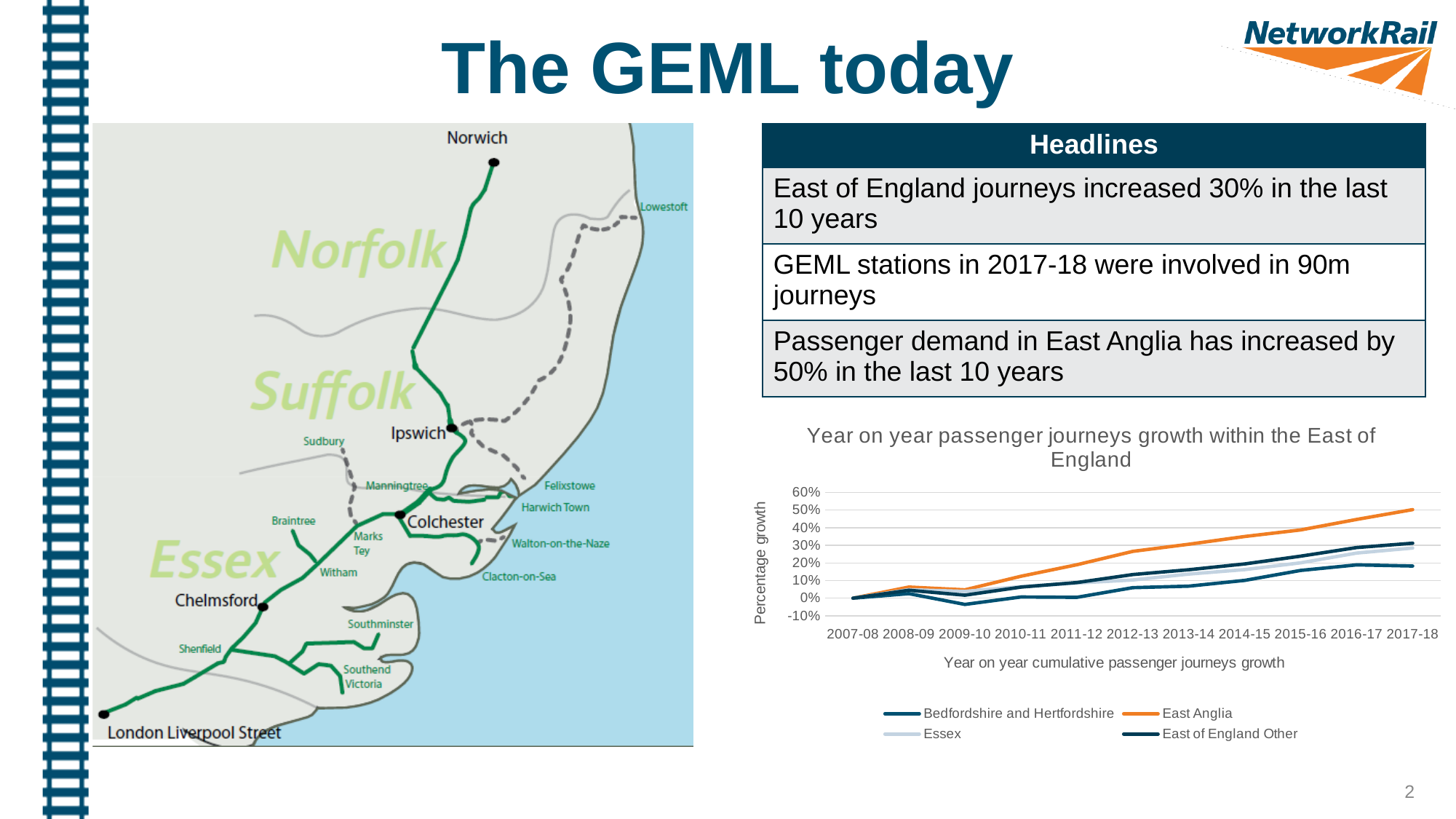
Is the value for Bedfordshire and Hertfordshire in 2017-18 greater or less than 30%? less How many years are shown along the x axis of the chart? 11 What is the label on the y axis of the chart? Percentage growth Is the value for East Anglia in 2017-18 greater or less than 40%? greater How many series does the legend of the chart list? 4 What kind of chart is shown on the slide? line chart Is the value for Bedfordshire and Hertfordshire in 2009-10 greater or less than 0%? less Which is larger in 2017-18, East Anglia or Essex? East Anglia What is the title of the chart? Year on year passenger journeys growth within the East of England Which series has the lowest value in 2017-18? Bedfordshire and Hertfordshire Which series has the highest value in 2017-18? East Anglia Does the East Anglia line rise or fall from 2009-10 to 2017-18? rise